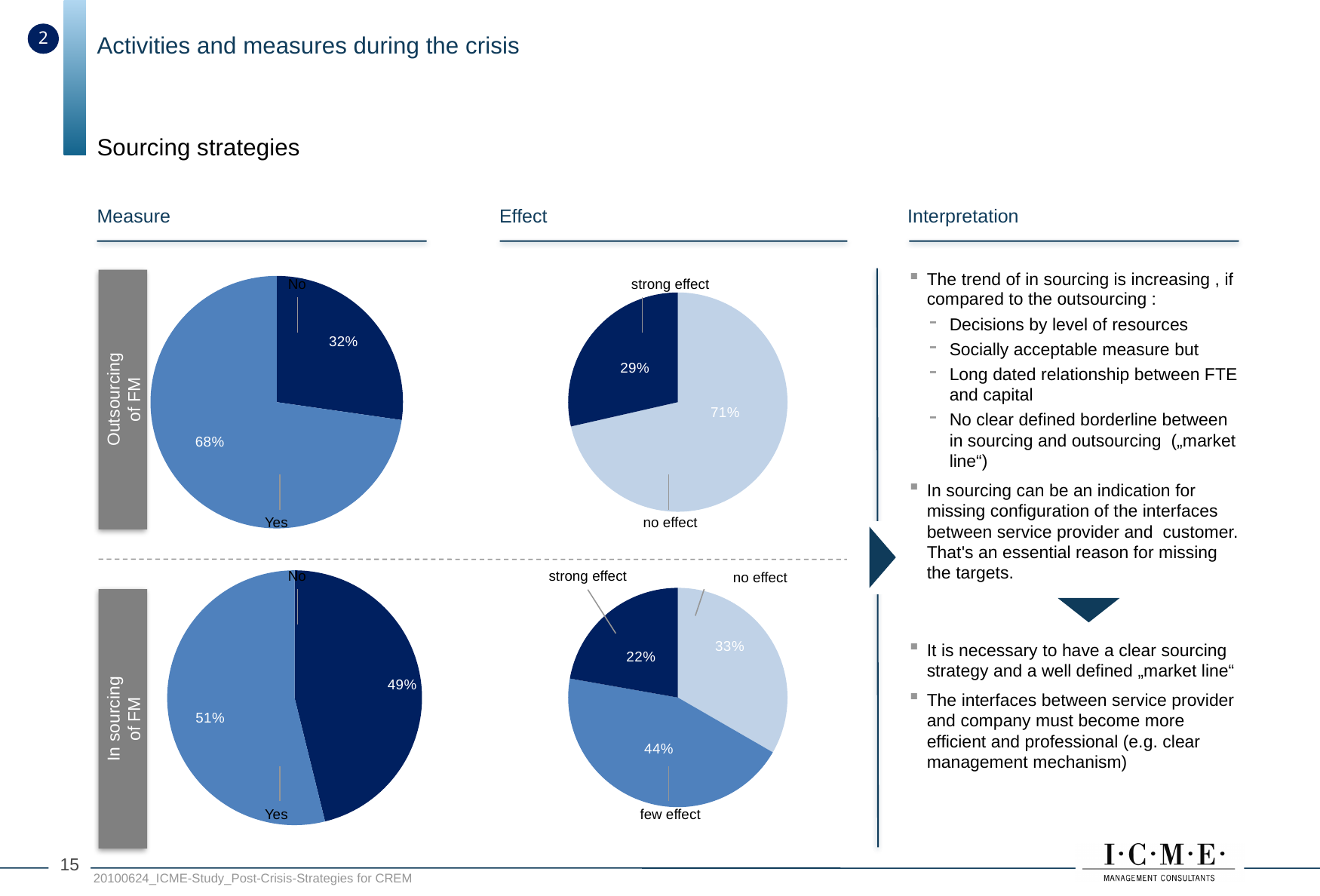
In the In sourcing of FM Effect pie chart (bottom middle), which category has the largest share? few effect In the Outsourcing of FM Effect pie chart (top middle), what share reported a strong effect? 29% In the Outsourcing of FM Measure pie chart (top left), what is the difference in percentage points between Yes and No? 36 percentage points In the In sourcing of FM Effect pie chart (bottom middle), what share reported few effect? 44% In the In sourcing of FM Effect pie chart (bottom middle), which category has the smallest share? strong effect What type of chart is used to show the Outsourcing of FM Measure data (top left)? Pie chart In the In sourcing of FM Measure pie chart (bottom left), what share answered Yes? 51% In the Outsourcing of FM Effect pie chart (top middle), is the share for no effect larger or smaller than the share for strong effect? Larger In the Outsourcing of FM Effect pie chart (top middle), what share reported no effect? 71% How many slices does the In sourcing of FM Effect pie chart (bottom middle) have? 3 In the Outsourcing of FM Measure pie chart (top left), what share of respondents answered No? 32% In the Outsourcing of FM Measure pie chart (top left), what share of respondents answered Yes? 68%